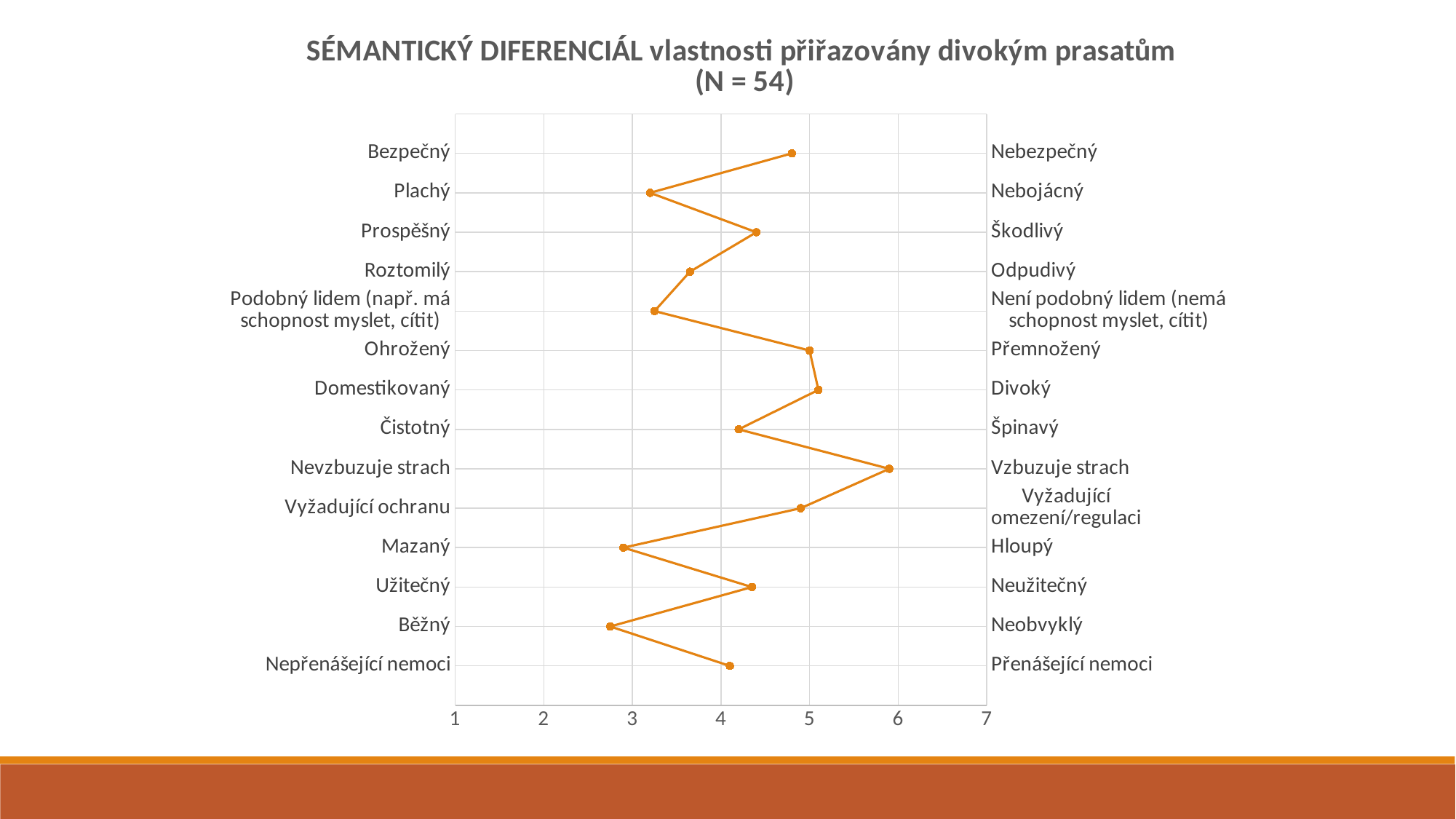
Is the value for Bezpečný / Nebezpečný greater or less than 4? greater Is the value for Ohrožený / Přemnožený greater or less than 4? greater Which attribute pair has the highest plotted value? Nevzbuzuje strach / Vzbuzuje strach Is the value for Plachý / Nebojácný greater or less than 4? less What kind of chart is shown on the slide? line chart Which has the larger value: Bezpečný / Nebezpečný or Plachý / Nebojácný? Bezpečný / Nebezpečný How many attribute pairs (categories) are plotted on the chart? 14 What sample size (N) is stated in the chart title? N = 54 Which has the larger value: Mazaný / Hloupý or Užitečný / Neužitečný? Užitečný / Neužitečný